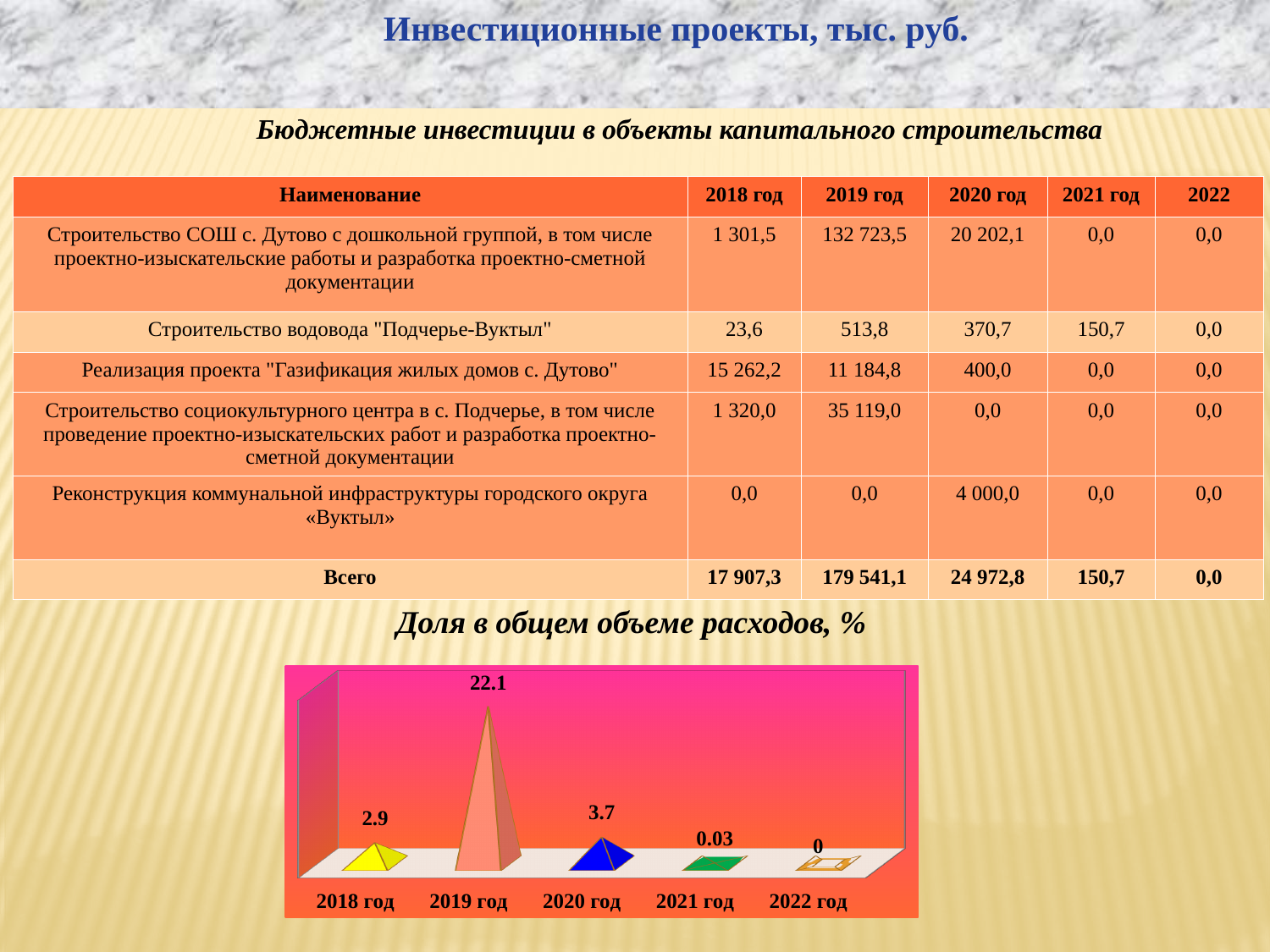
In the chart 'Доля в общем объеме расходов, %', which is larger: the value for 2018 год or the value for 2020 год? 2020 год What kind of chart is 'Доля в общем объеме расходов, %'? Bar chart How many years are shown on the x axis of the chart 'Доля в общем объеме расходов, %'? 5 What is the value for 2022 год in the chart 'Доля в общем объеме расходов, %'? 0 What is the value for 2019 год in the chart 'Доля в общем объеме расходов, %'? 22.1 What is the value for 2018 год in the chart 'Доля в общем объеме расходов, %'? 2.9 In the chart 'Доля в общем объеме расходов, %', what is the difference between the values for 2019 год and 2020 год? 18.4 What is the title of the chart at the bottom of the slide? Доля в общем объеме расходов, % Which year has the lowest value in the chart 'Доля в общем объеме расходов, %'? 2022 год What is the value for 2021 год in the chart 'Доля в общем объеме расходов, %'? 0.03 What is the value for 2020 год in the chart 'Доля в общем объеме расходов, %'? 3.7 Which year has the highest value in the chart 'Доля в общем объеме расходов, %'? 2019 год